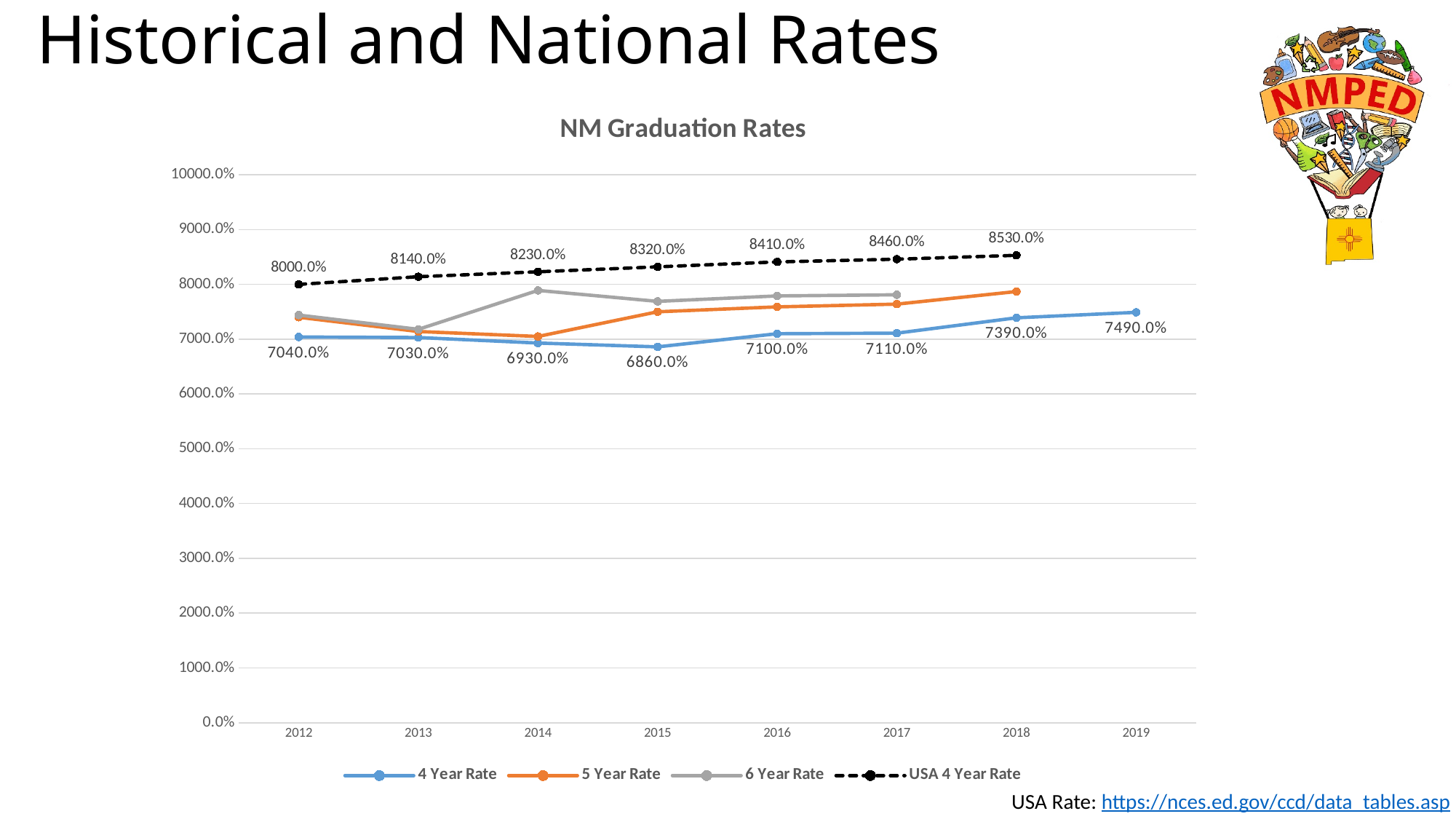
In which year is the 4 Year Rate highest? 2019 In which year is the 4 Year Rate lowest? 2015 What is the 4 Year Rate for 2019? 7490.0% What is the 4 Year Rate for 2015? 6860.0% Does the USA 4 Year Rate rise or fall from 2012 to 2018? rise What is the difference between the USA 4 Year Rate and the 4 Year Rate in 2012? 960.0% How many series does the legend list? 4 Is the 5 Year Rate for 2018 greater or less than 7000.0%? greater What kind of chart is shown? line chart Which is larger in 2017, the USA 4 Year Rate or the 4 Year Rate? USA 4 Year Rate What is the USA 4 Year Rate for 2018? 8530.0% How many years are shown on the x axis? 8